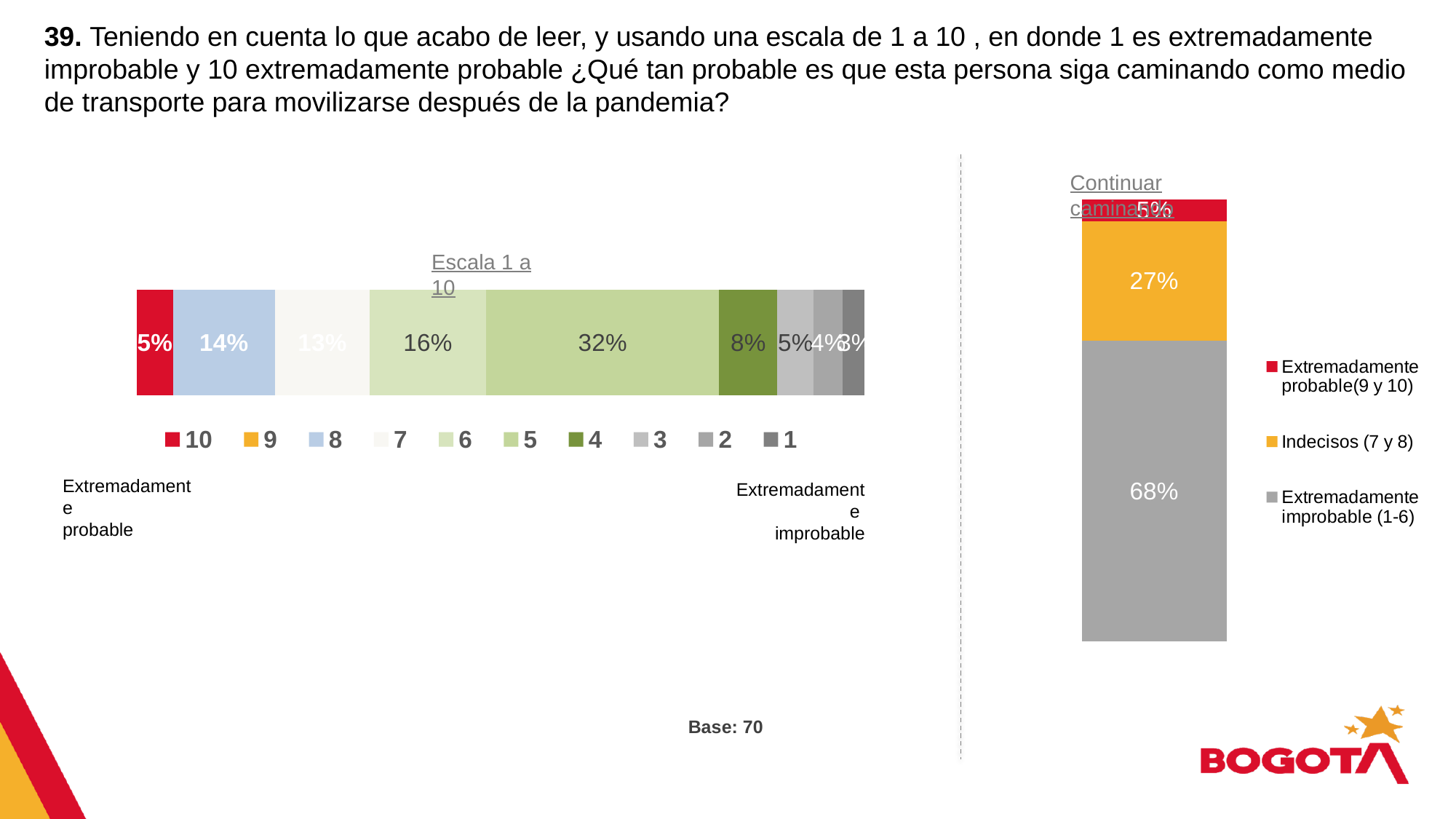
In the right chart (Continuar caminando), how many series does the legend list? 3 In the left chart (Escala 1 a 10), what is the difference between the percentages for scale values 5 and 6? 16 percentage points In the right chart (Continuar caminando), what percentage is shown for Extremadamente improbable (1-6)? 68% In the left chart (Escala 1 a 10), how many entries does the legend list? 10 In the left chart (Escala 1 a 10), what percentage is shown for scale value 5? 32% What type of chart is the left chart (Escala 1 a 10)? Stacked bar chart In the right chart (Continuar caminando), what percentage is shown for Indecisos (7 y 8)? 27% In the left chart (Escala 1 a 10), which has a larger percentage, scale value 8 or scale value 7? 8 In the left chart (Escala 1 a 10), what percentage is shown for scale value 8? 14% In the left chart (Escala 1 a 10), which scale value has the largest segment? 5 In the right chart (Continuar caminando), which category has the largest share? Extremadamente improbable (1-6) In the right chart (Continuar caminando), what is the difference between Extremadamente improbable (1-6) and Indecisos (7 y 8)? 41 percentage points